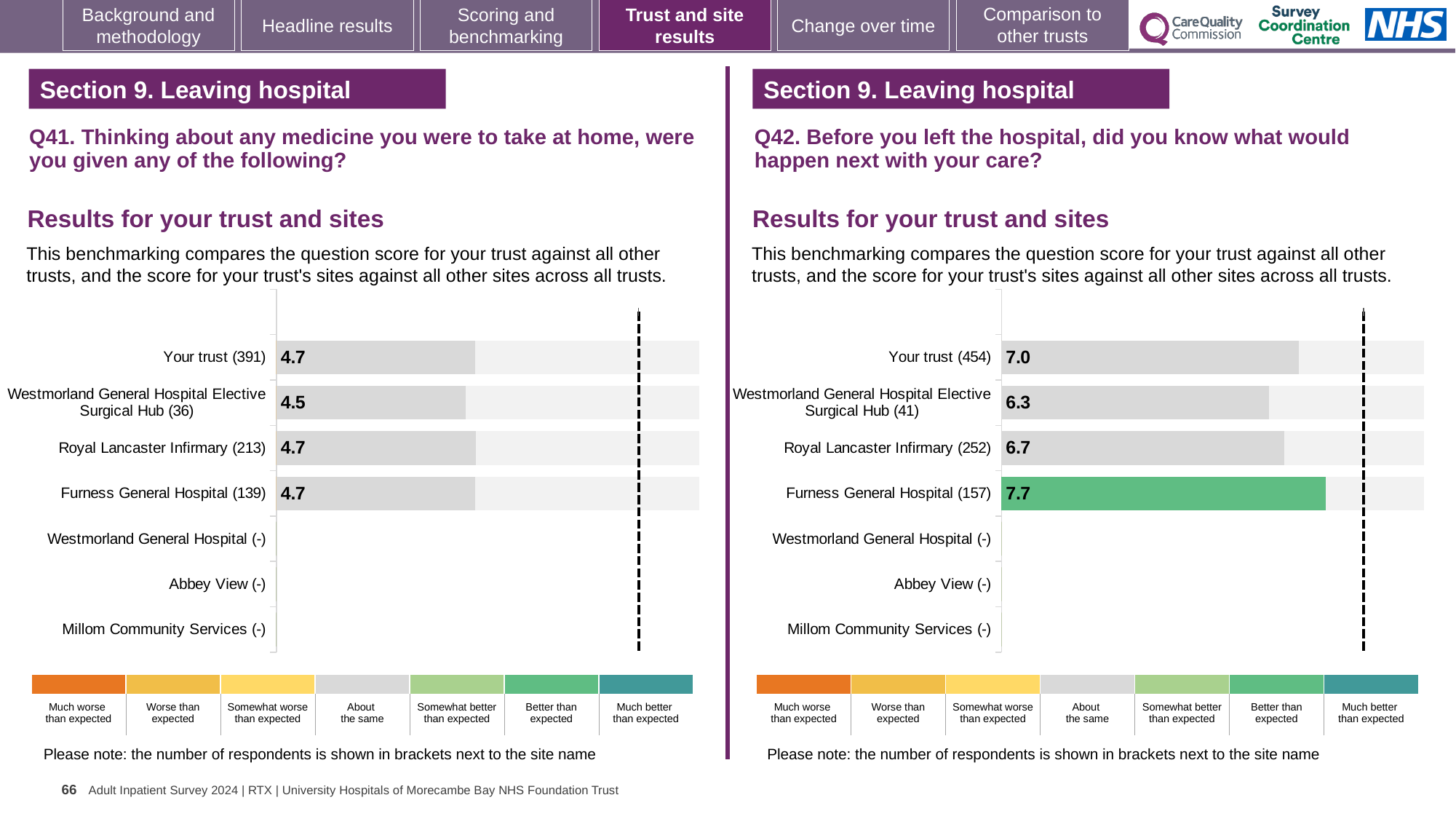
In the Q41 chart on the left, what is the score for Westmorland General Hospital Elective Surgical Hub? 4.5 In the Q41 chart on the left, what is the score for Your trust? 4.7 In the Q41 chart on the left, which site has the lowest score? Westmorland General Hospital Elective Surgical Hub In the Q42 chart on the right, what is the score for Royal Lancaster Infirmary? 6.7 In the Q42 chart on the right, what is the difference between the scores for Furness General Hospital and Westmorland General Hospital Elective Surgical Hub? 1.4 What kind of chart is used for the Q41 results on the left? Bar chart In the Q42 chart on the right, what is the score for Furness General Hospital? 7.7 In the Q42 chart on the right, what is the score for Your trust? 7.0 In the Q41 chart on the left, what is the difference between the scores for Royal Lancaster Infirmary and Westmorland General Hospital Elective Surgical Hub? 0.2 In the Q42 chart on the right, which has the larger score, Your trust or Royal Lancaster Infirmary? Your trust In the Q42 chart on the right, which site has the highest score? Furness General Hospital In the Q42 chart on the right, which site has the lowest score? Westmorland General Hospital Elective Surgical Hub